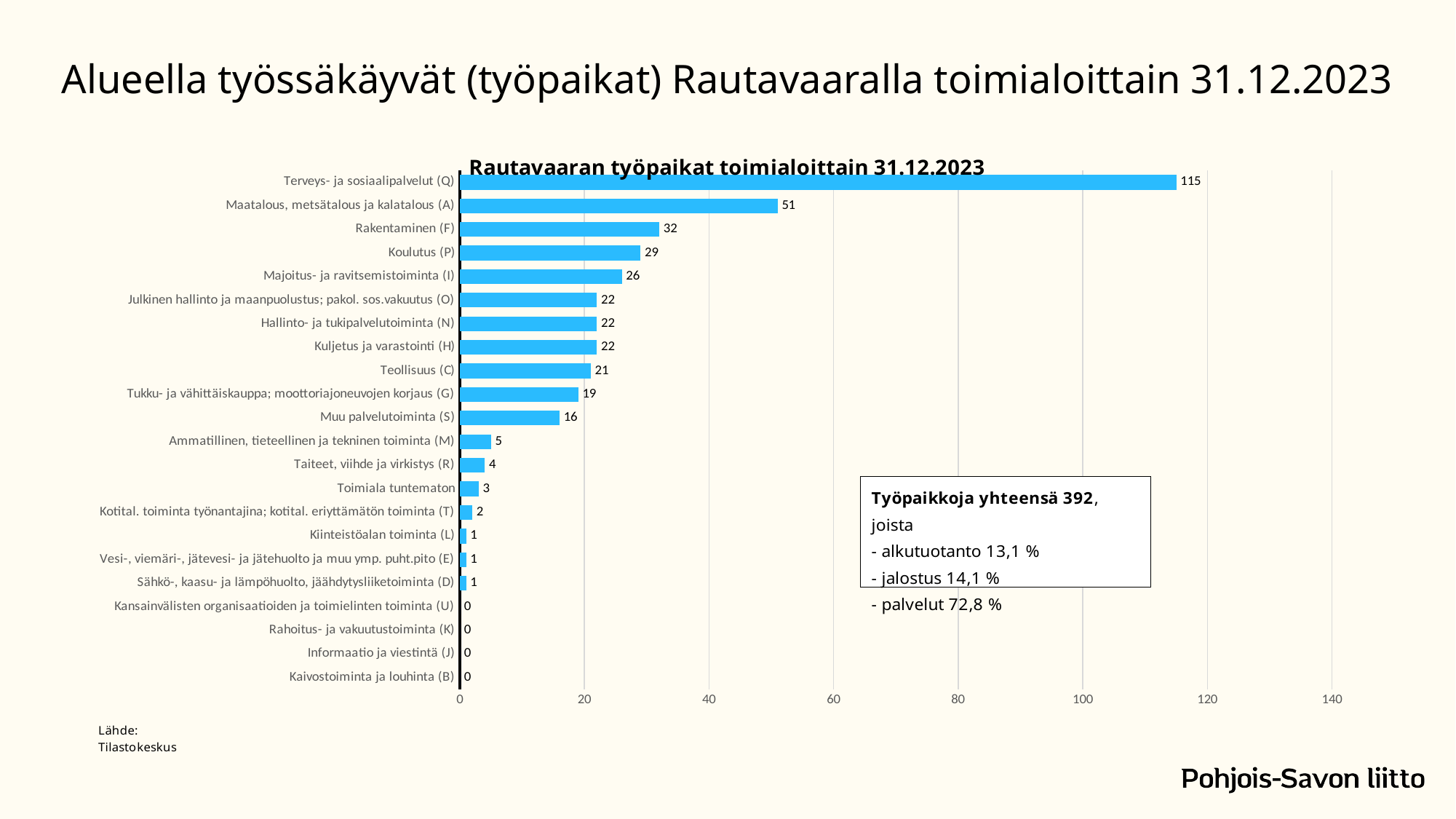
What is the difference between Rakentaminen (F) and Teollisuus (C)? 11 What is the value for Maatalous, metsätalous ja kalatalous (A)? 51 What is the value for Terveys- ja sosiaalipalvelut (Q)? 115 What is the title of the chart? Rautavaaran työpaikat toimialoittain 31.12.2023 Which category has the highest value? Terveys- ja sosiaalipalvelut (Q) How many categories are shown on the chart? 22 Which is larger, Majoitus- ja ravitsemistoiminta (I) or Muu palvelutoiminta (S)? Majoitus- ja ravitsemistoiminta (I) What is the value for Tukku- ja vähittäiskauppa; moottoriajoneuvojen korjaus (G)? 19 What kind of chart is shown? bar chart Is the value for Maatalous, metsätalous ja kalatalous (A) greater or less than 40? greater What is the value for Kaivostoiminta ja louhinta (B)? 0 What is the value for Koulutus (P)? 29